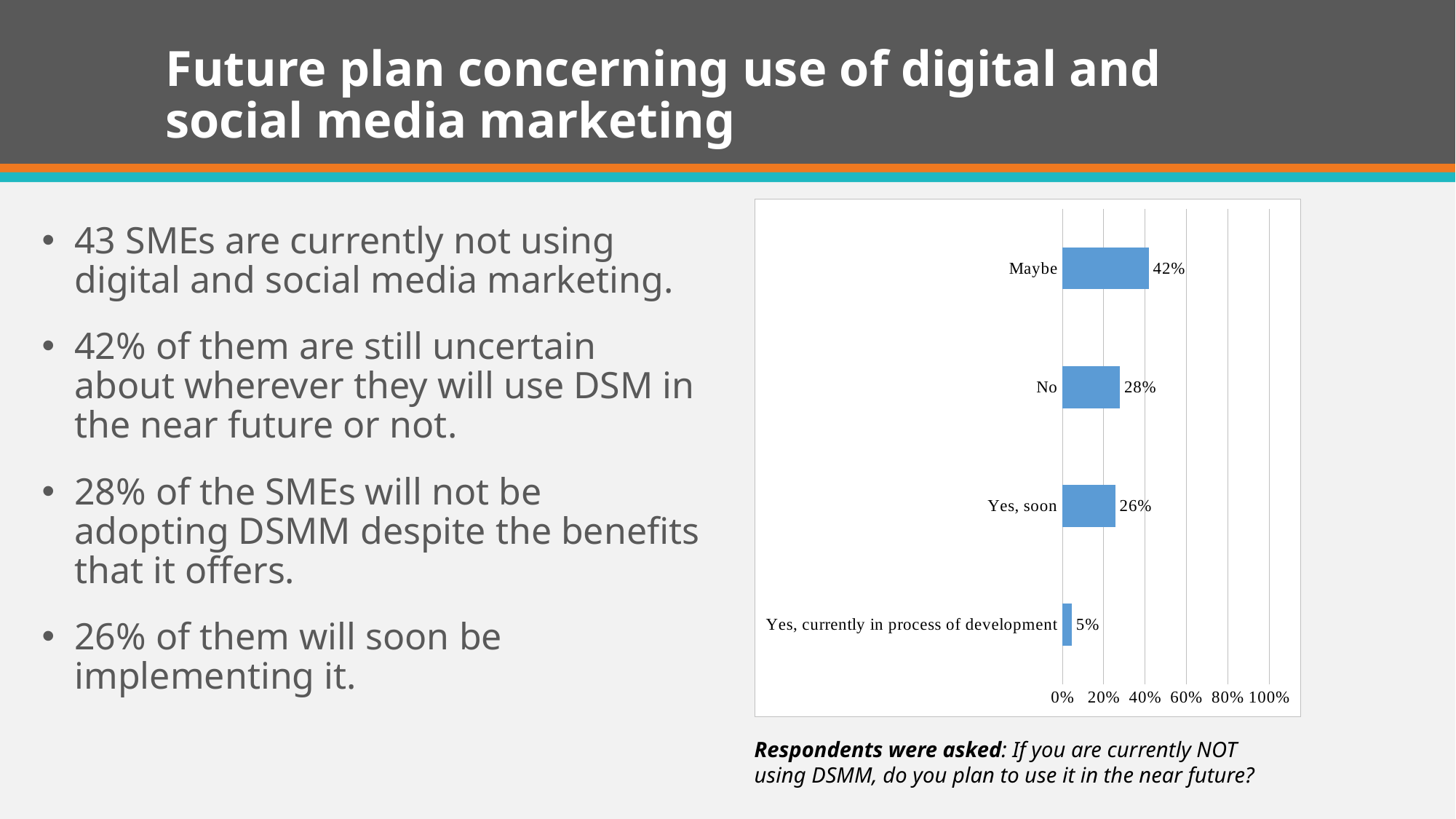
What is the difference between the values for No and Yes, soon? 2% What is the value for No? 28% What is the value for Maybe? 42% What is the value for Yes, currently in process of development? 5% Which is larger, the value for Maybe or the value for Yes, soon? Maybe What kind of chart is shown on the slide? bar chart What is the difference between the values for Maybe and No? 14% Is the value for Maybe greater or less than 40%? greater What is the value for Yes, soon? 26% How many categories are shown in the chart? 4 Which category has the highest value? Maybe Which category has the lowest value? Yes, currently in process of development